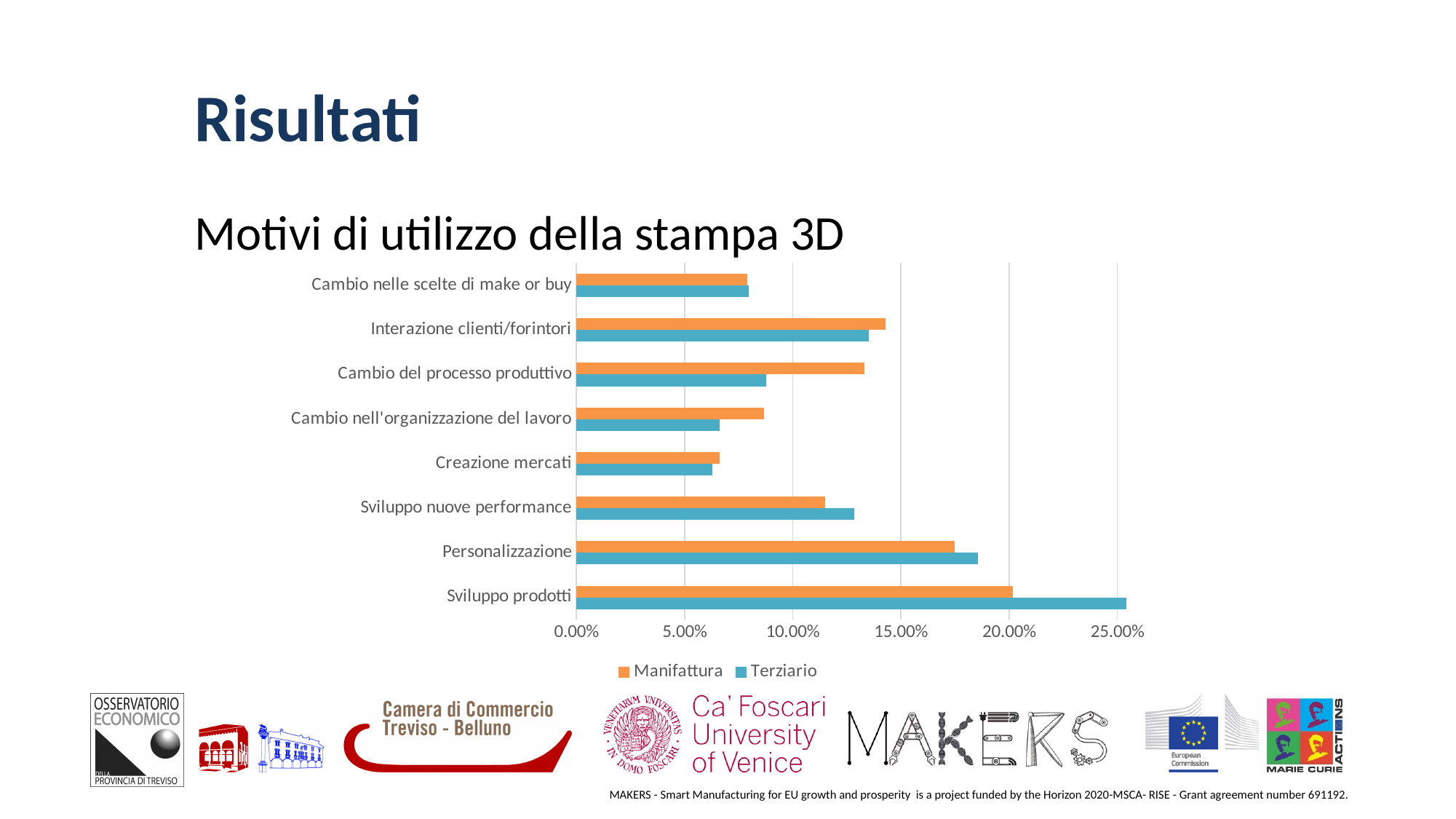
Which category has the highest value for Terziario? Sviluppo prodotti What kind of chart is shown on the slide? Bar chart For Cambio del processo produttivo, which series has the larger value, Manifattura or Terziario? Manifattura Is the Terziario value for Sviluppo nuove performance greater or less than 10.00%? greater Is the Manifattura value for Personalizzazione greater or less than 20.00%? less Is the Terziario value for Cambio del processo produttivo greater or less than 10.00%? less Which category has the lowest value for Manifattura? Creazione mercati Which colour represents the Terziario series in the chart? Blue Which category has the highest value for Manifattura? Sviluppo prodotti How many series does the legend list? 2 How many categories (reasons) are listed on the chart? 8 For Sviluppo prodotti, which series has the larger value, Manifattura or Terziario? Terziario